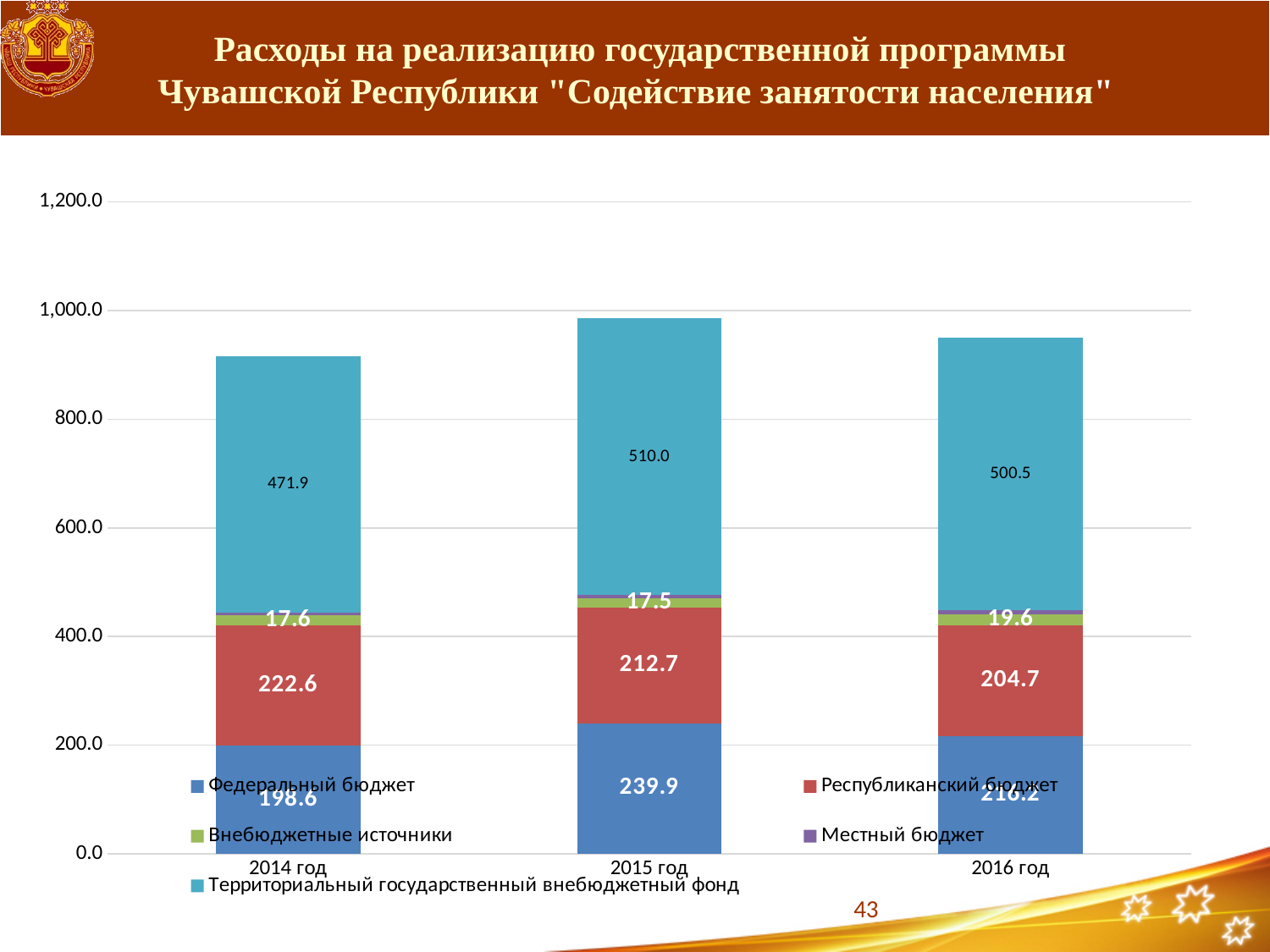
How many years are shown on the x axis? 3 Which colour represents Федеральный бюджет in the chart? blue Which year has the larger Федеральный бюджет value, 2014 год or 2015 год? 2015 год What is the value for Республиканский бюджет in 2014 год? 222.6 How many series does the legend list? 5 What is the value for Внебюджетные источники in 2016 год? 19.6 What is the difference between the Республиканский бюджет values for 2014 год and 2016 год? 17.9 In which year is the value for Территориальный государственный внебюджетный фонд the highest? 2015 год Is the total height of the stacked bar for 2015 год greater or less than 800.0? greater What kind of chart is shown on the slide? bar chart What is the value for Территориальный государственный внебюджетный фонд in 2015 год? 510.0 What is the value for Федеральный бюджет in 2015 год? 239.9